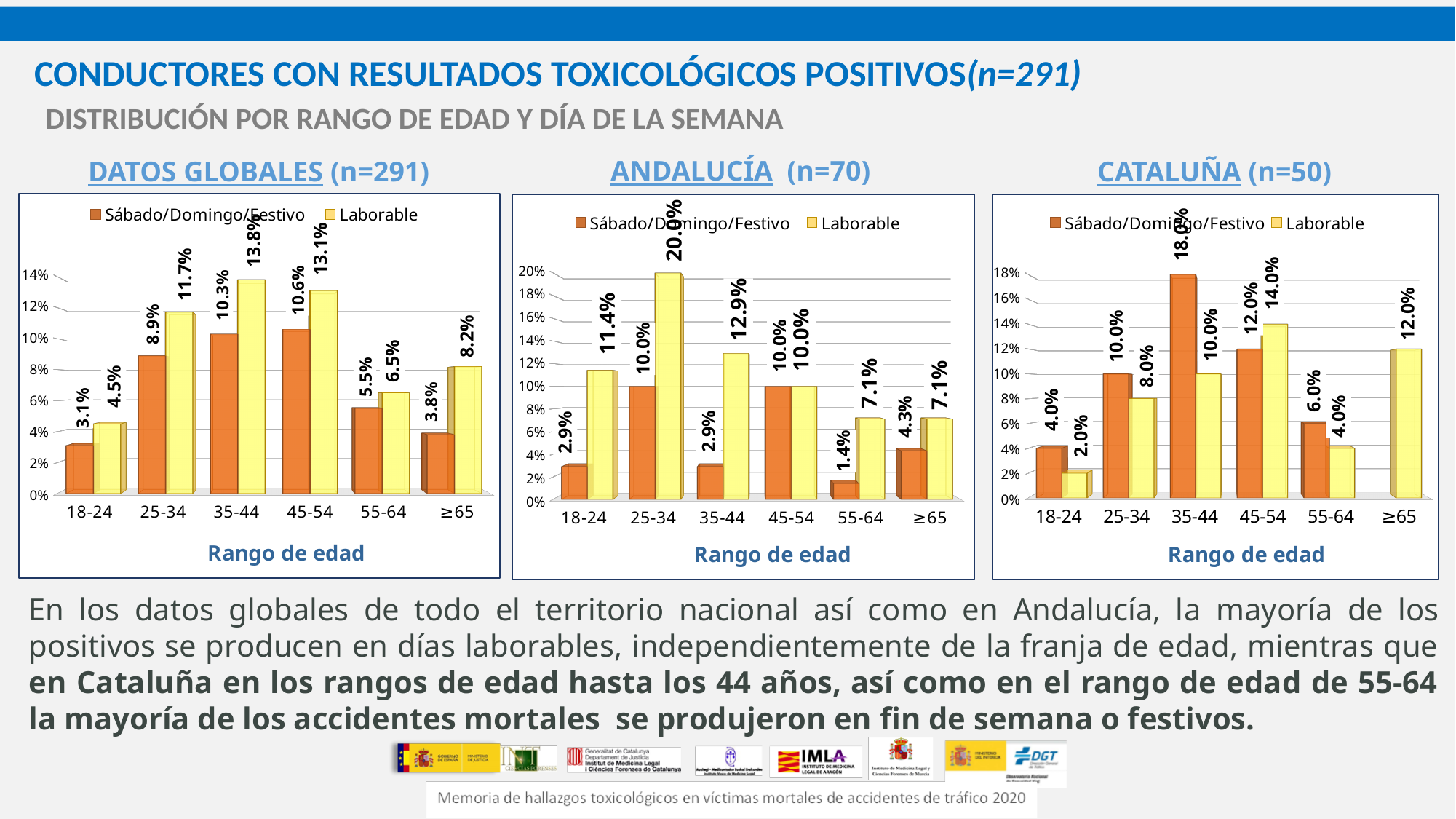
In the DATOS GLOBALES chart, what is the Laborable value for the 35-44 age range? 13.8% In the DATOS GLOBALES chart, what is the difference between the Laborable and Sábado/Domingo/Festivo values for the ≥65 age range? 4.4% In the ANDALUCÍA chart, what is the Sábado/Domingo/Festivo value for the 55-64 age range? 1.4% In the ANDALUCÍA chart, which age range has the highest Laborable value? 25-34 In the ANDALUCÍA chart, which age range has the lowest Sábado/Domingo/Festivo value? 55-64 In the CATALUÑA chart, what is the difference between the Sábado/Domingo/Festivo and Laborable values for the 25-34 age range? 2.0% What type of chart is the CATALUÑA chart? Bar chart In the DATOS GLOBALES chart, what is the Sábado/Domingo/Festivo value for the 45-54 age range? 10.6% In the CATALUÑA chart, which is larger for the 45-54 age range, Sábado/Domingo/Festivo or Laborable? Laborable How many age ranges are shown on the x axis of the DATOS GLOBALES chart? 6 How many series does the legend of the ANDALUCÍA chart list? 2 In the CATALUÑA chart, what is the Sábado/Domingo/Festivo value for the 35-44 age range? 18.0%